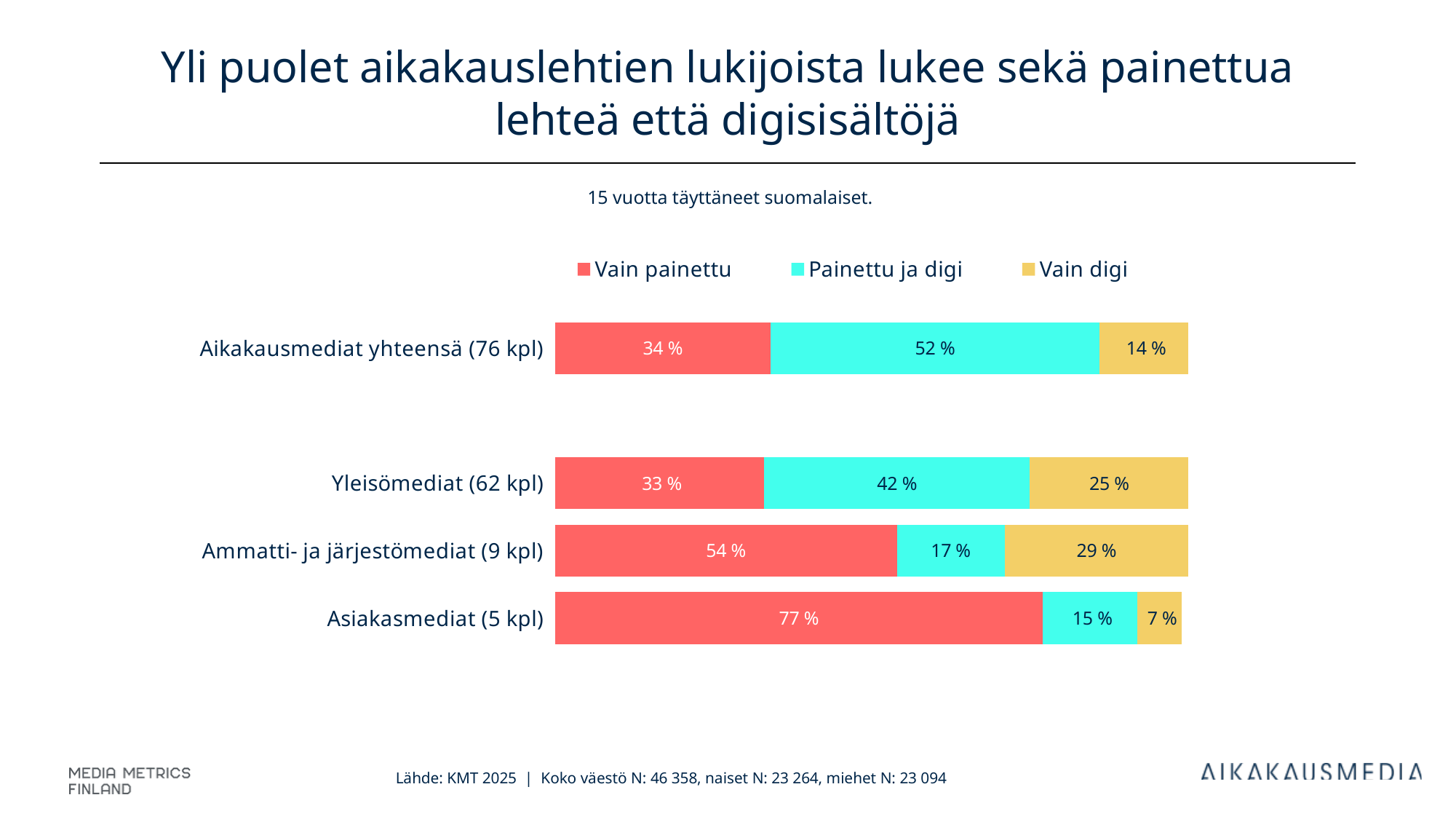
Which is larger: the "Vain digi" value for "Ammatti- ja järjestömediat (9 kpl)" or for "Yleisömediat (62 kpl)"? Ammatti- ja järjestömediat (9 kpl) Which category has the lowest "Vain digi" value? Asiakasmediat (5 kpl) What is the value for "Painettu ja digi" in the "Ammatti- ja järjestömediat (9 kpl)" bar? 17 % What is the value for "Painettu ja digi" in the "Aikakausmediat yhteensä (76 kpl)" bar? 52 % What is the value for "Vain digi" in the "Yleisömediat (62 kpl)" bar? 25 % What is the value for "Vain painettu" in the "Asiakasmediat (5 kpl)" bar? 77 % What is the difference between the "Vain painettu" values for "Asiakasmediat (5 kpl)" and "Yleisömediat (62 kpl)"? 44 % What kind of chart is shown on the slide? Stacked bar chart What colour represents the "Vain digi" series in the legend? Yellow How many series does the legend list? 3 Which category has the highest "Vain painettu" value? Asiakasmediat (5 kpl) How many categories (bars) are shown in the chart? 4